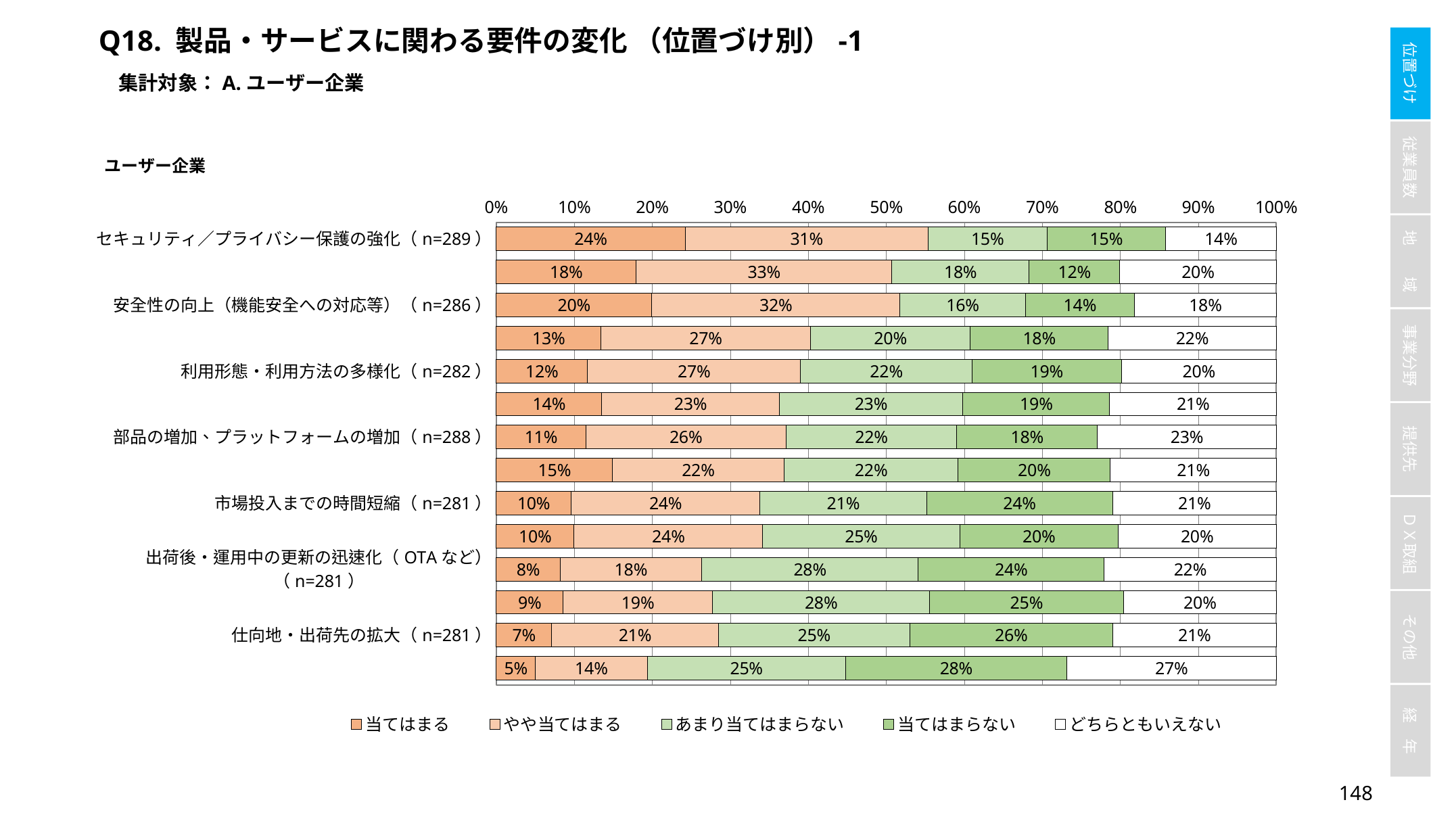
How many series does the legend list? 5 What is the どちらともいえない value for 部品の増加、プラットフォームの増加 (n=288)? 23% What is the やや当てはまる value for 安全性の向上（機能安全への対応等）(n=286)? 32% What is the last entry in the legend? どちらともいえない What is the 当てはまらない value for 仕向地・出荷先の拡大 (n=281)? 26% Which is larger: the 当てはまらない value for 市場投入までの時間短縮 (n=281) or for 利用形態・利用方法の多様化 (n=282)? 市場投入までの時間短縮 (n=281) What is the 当てはまる value for セキュリティ／プライバシー保護の強化 (n=289)? 24% Among the labeled categories, which has the highest 当てはまる value? セキュリティ／プライバシー保護の強化 (n=289) What kind of chart is shown on the slide? stacked bar chart Among the labeled categories, which has the lowest 当てはまる value? 仕向地・出荷先の拡大 (n=281) What is the あまり当てはまらない value for 出荷後・運用中の更新の迅速化（OTAなど）(n=281)? 28% What is the difference between the やや当てはまる values for セキュリティ／プライバシー保護の強化 (n=289) and 市場投入までの時間短縮 (n=281)? 7%